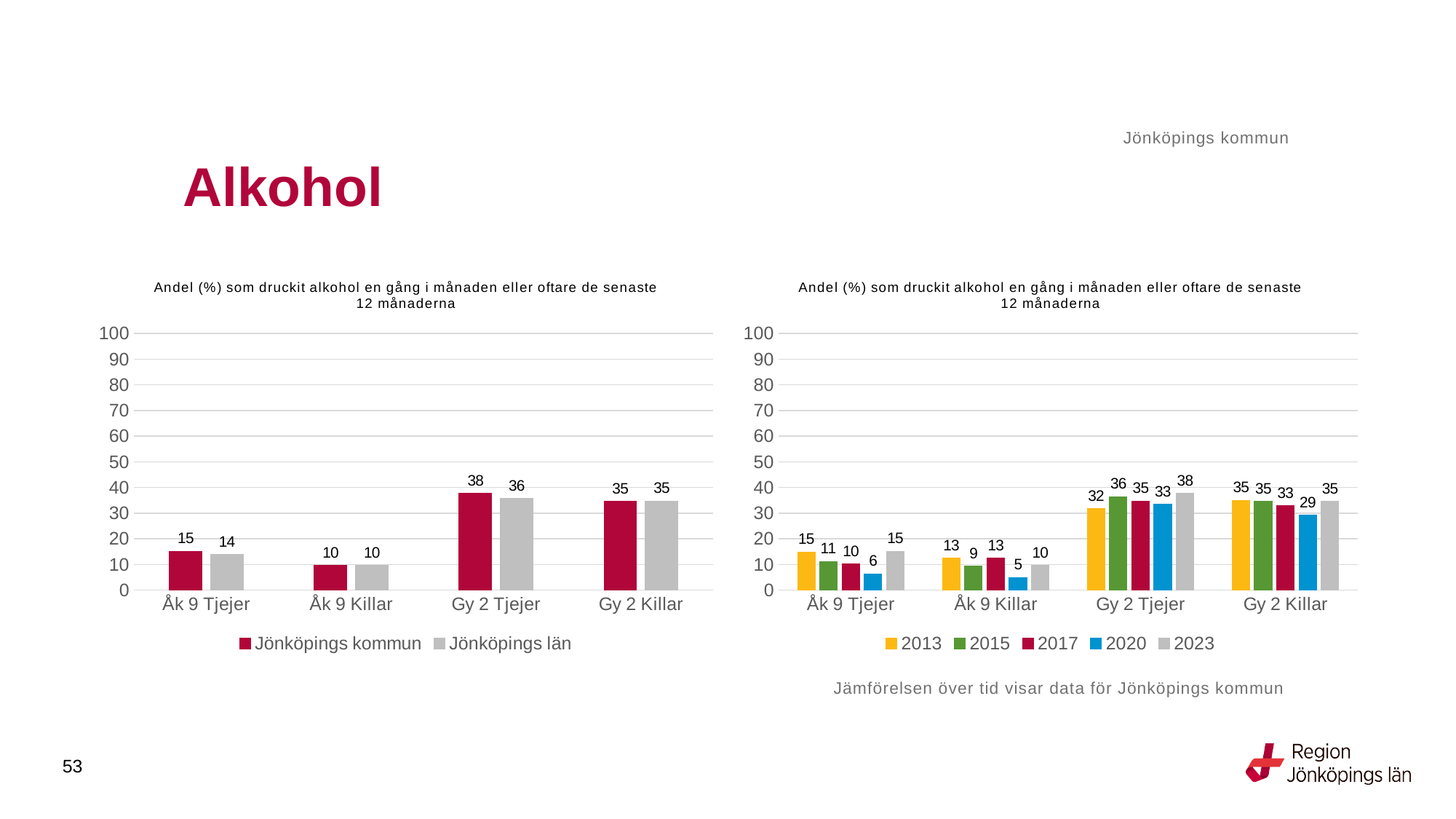
What kind of chart is the right chart? bar chart In the right chart, which year has the highest value for Gy 2 Tjejer? 2023 In the right chart, what is the value for 2020 for Åk 9 Killar? 5 In the right chart, which year has the lowest value for Gy 2 Killar? 2020 In the left chart, how many series does the legend list? 2 In the right chart, is the value for 2013 for Åk 9 Tjejer larger or smaller than the value for 2020 for Åk 9 Tjejer? larger In the left chart, what is the value for Jönköpings kommun for Gy 2 Tjejer? 38 In the left chart, what is the difference between Jönköpings kommun and Jönköpings län for Gy 2 Tjejer? 2 In the left chart, what is the value for Jönköpings län for Åk 9 Tjejer? 14 In the right chart, how many series does the legend list? 5 In the left chart, which category has the lowest value for Jönköpings kommun? Åk 9 Killar In the right chart, what is the value for 2023 for Gy 2 Tjejer? 38